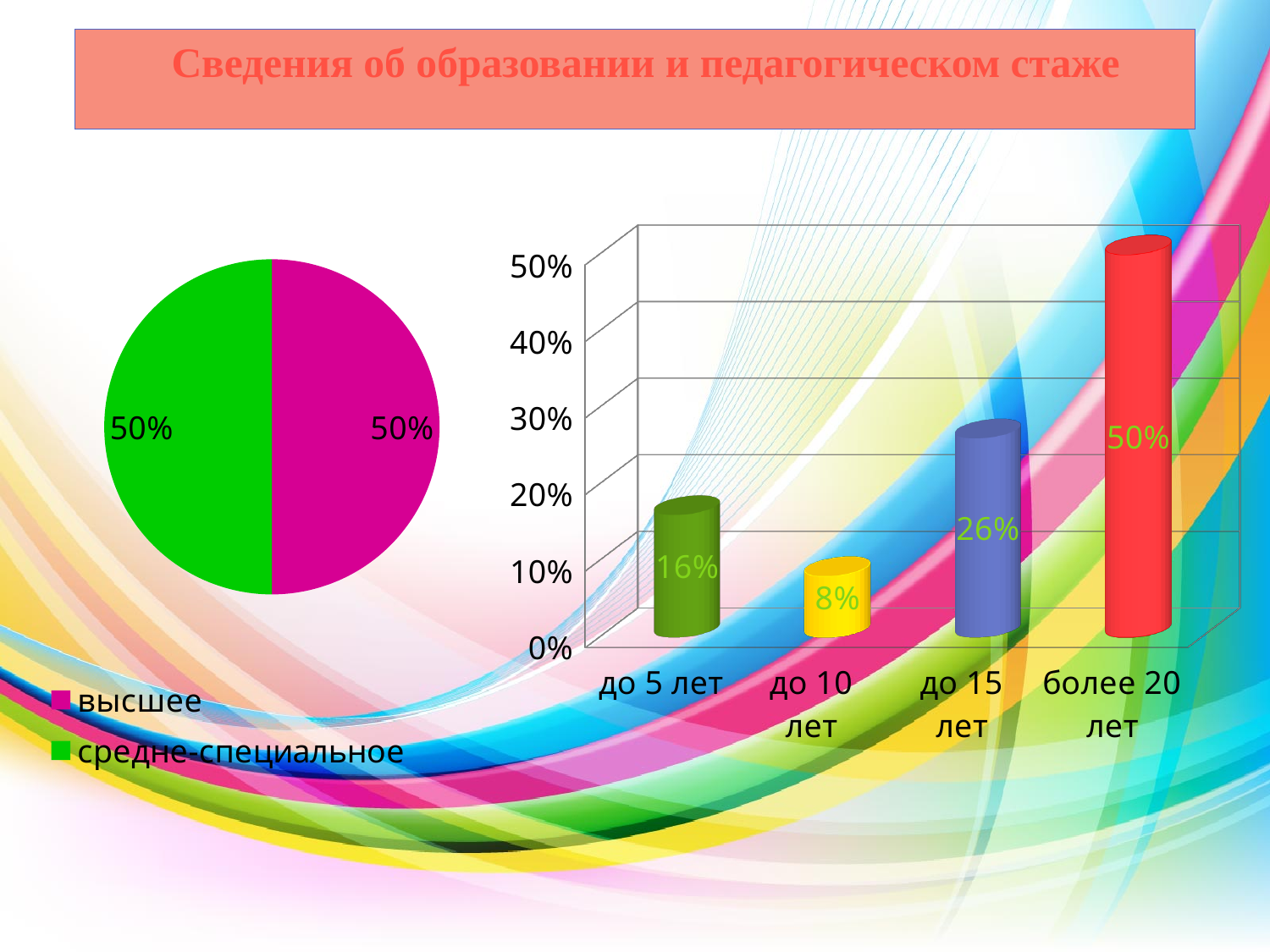
What kind of chart is the chart on the right? bar chart In the bar chart on the right, which category has the highest value? более 20 лет In the bar chart on the right, what is the difference between the values for более 20 лет and до 15 лет? 24% In the pie chart on the left, what share is labelled for средне-специальное? 50% What kind of chart is the chart on the left? pie chart In the bar chart on the right, what is the value for более 20 лет? 50% How many categories are shown in the bar chart on the right? 4 In the bar chart on the right, what is the value for до 5 лет? 16% In the bar chart on the right, what is the value for до 10 лет? 8% How many entries does the legend of the pie chart on the left list? 2 In the bar chart on the right, which category has the lowest value? до 10 лет In the pie chart on the left, what share is labelled for высшее? 50%